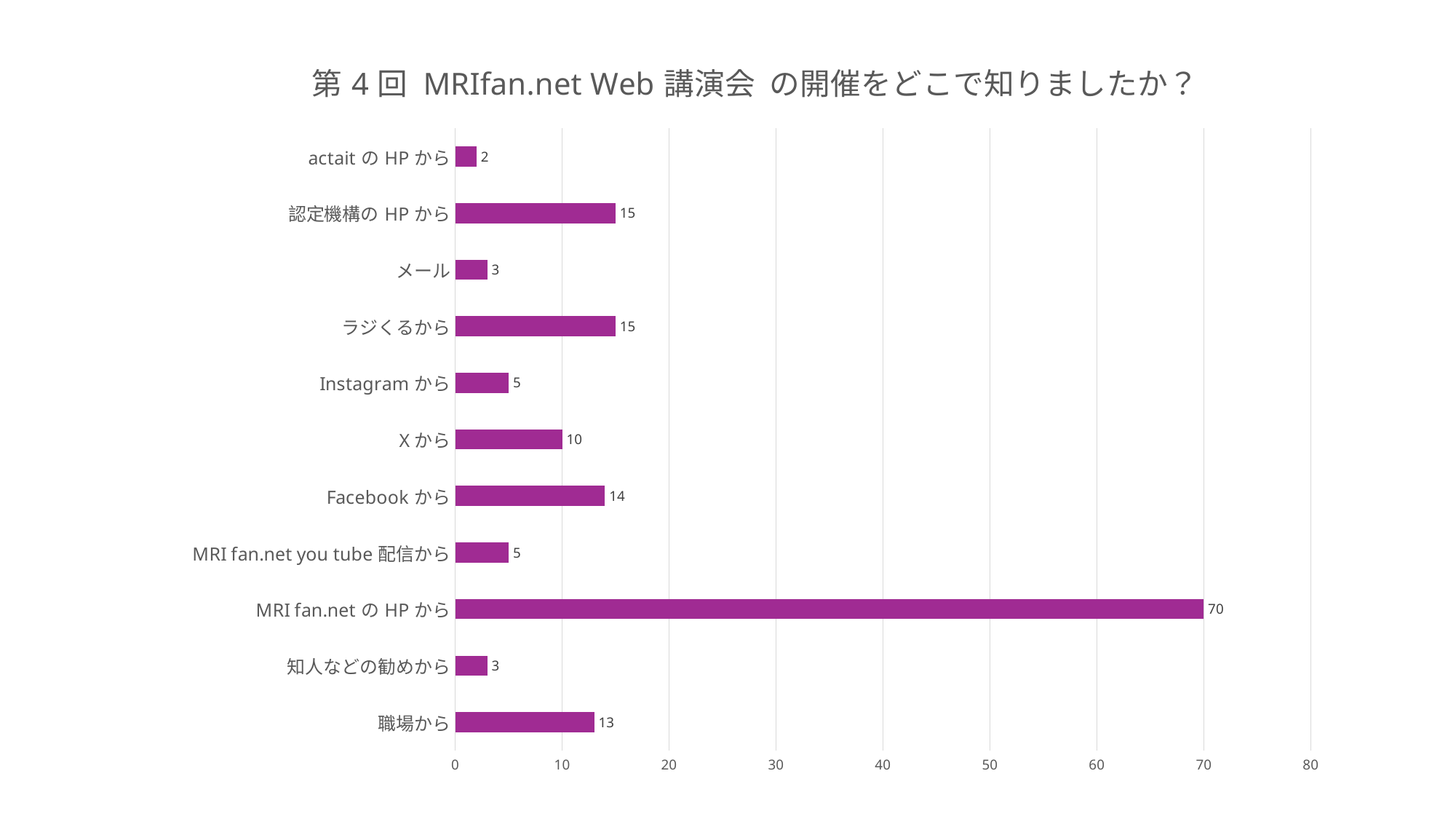
What is the difference between the values for X から and Instagram から? 5 What is the value for 職場から? 13 What is the value for Facebook から? 14 Which category has the highest value? MRI fan.net の HP から Which is larger, the value for Facebook から or the value for 職場から? Facebook から What is the difference between the values for MRI fan.net の HP から and 認定機構の HP から? 55 What is the title of the chart? 第 4 回 MRIfan.net Web 講演会 の開催をどこで知りましたか？ Which category has the lowest value? actait の HP から Is the value for MRI fan.net の HP から greater or less than 60? greater How many categories are shown in the chart? 11 What is the value for MRI fan.net の HP から? 70 What kind of chart is shown on the slide? bar chart